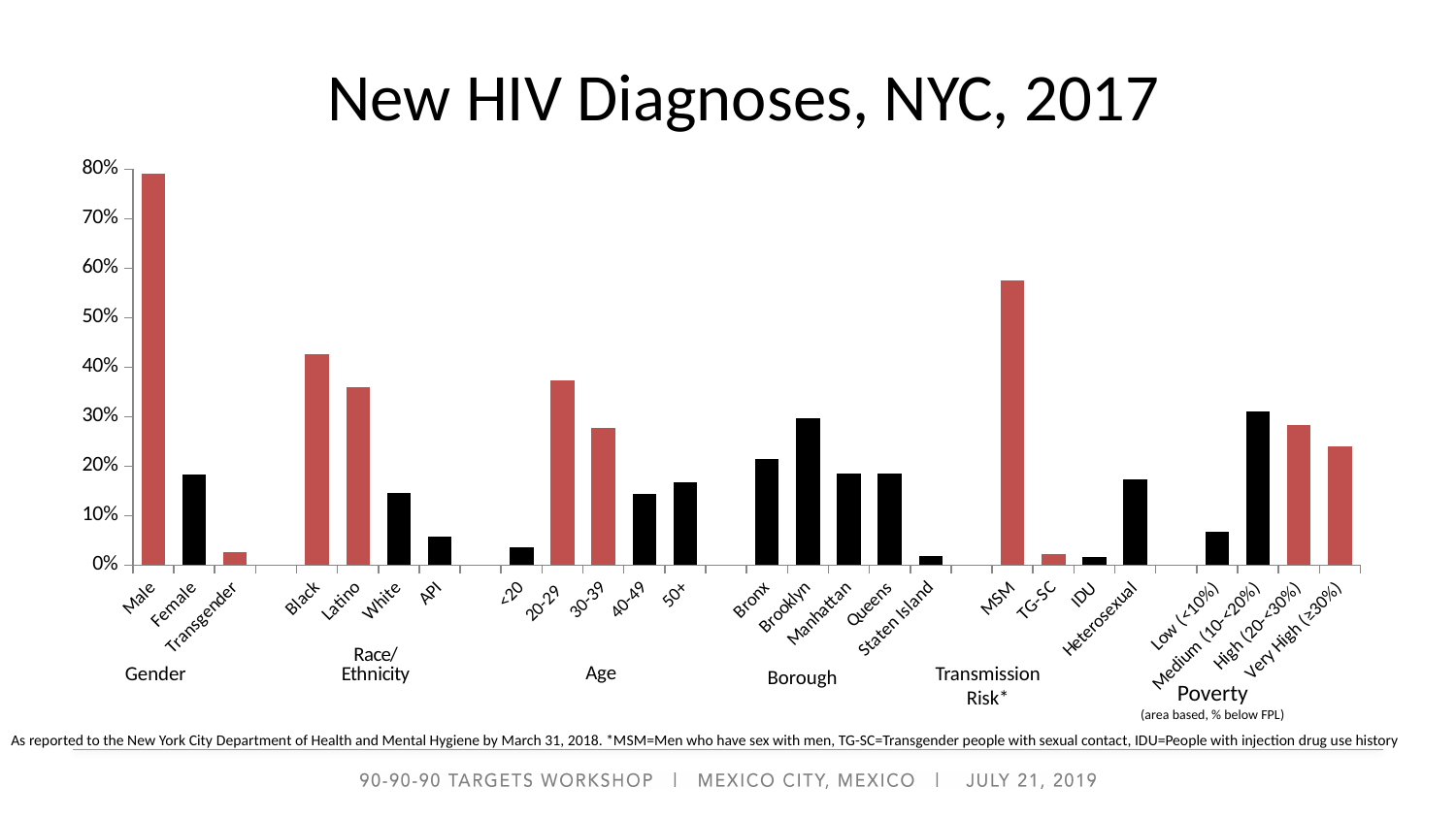
Within the Borough group, which borough has the lowest bar? Staten Island What kind of chart is shown on the slide? bar chart What is the title of the chart? New HIV Diagnoses, NYC, 2017 Is the value for Male greater or less than 70%? greater Which is larger, the value for 20-29 or the value for 30-39? 20-29 Is the value for MSM greater or less than 50%? greater How many borough categories are shown in the Borough group? 5 Within the Borough group, which borough has the highest bar? Brooklyn Which category has the highest bar in the whole chart? Male Is the value for Very High (≥30%) poverty greater or less than 30%? less Which is larger, the value for Black or the value for Latino? Black